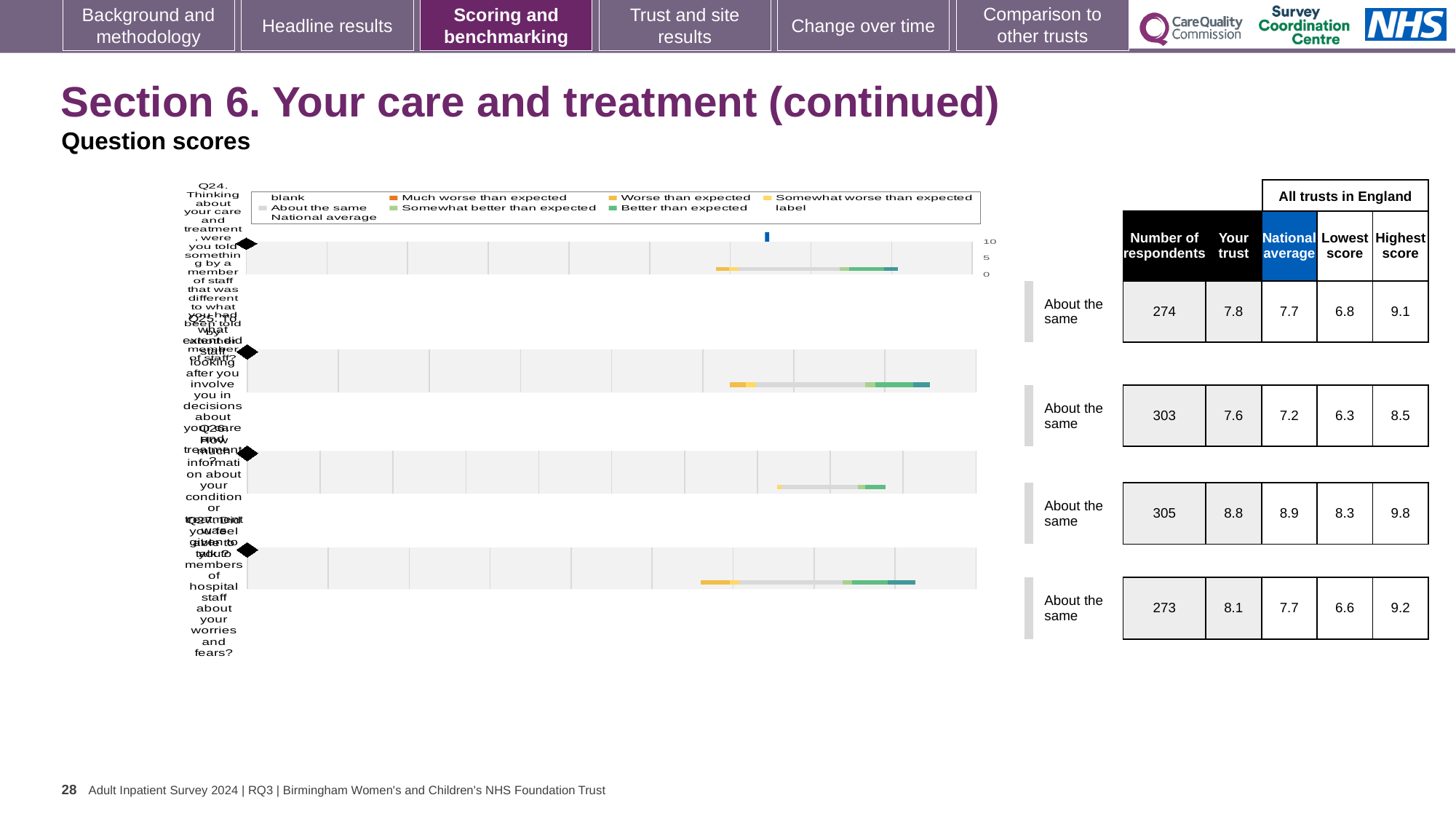
Which row has the highest 'Your trust' score? Q26 (third row), 8.8 How many entries does the chart legend list? 9 How many questions (rows) are plotted in the chart? 4 For the second row (Q25), which is larger: the 'Your trust' score or the national average? Your trust (7.6) What benchmark category is shown for all four questions? About the same What is the difference between the 'Your trust' score and the national average for the first row (Q24)? 0.1 What is the national average for the fourth row (Q27)? 7.7 What kind of chart is used to show the question scores on this slide? bar chart What is the number of respondents for the third row (Q26)? 305 What is the highest score across all trusts in England for the fourth row (Q27)? 9.2 Which row has the lowest 'Lowest score' value? Q25 (second row), 6.3 What is the 'Your trust' score for the first row (Q24)? 7.8